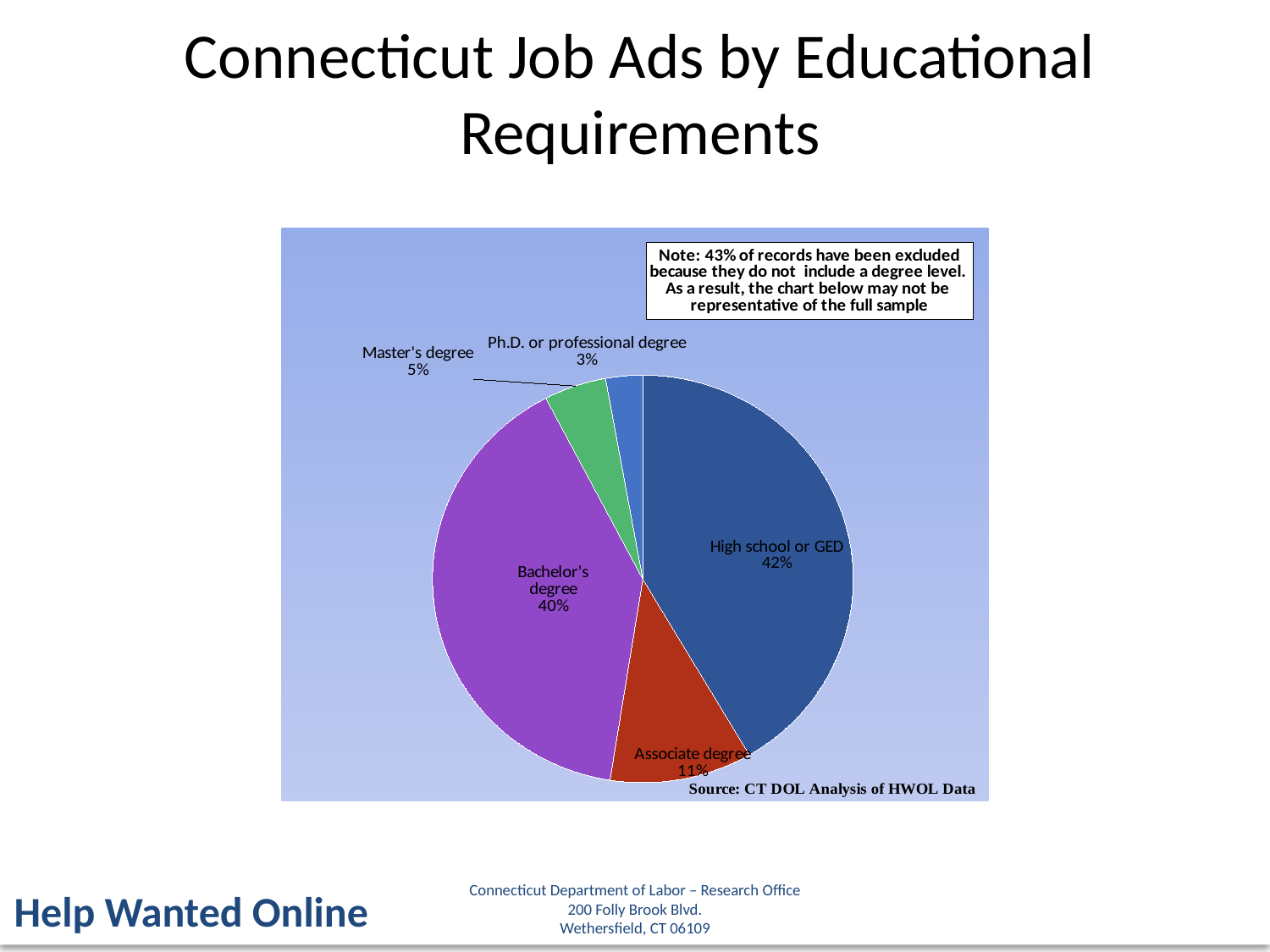
Which educational requirement has the smallest share of job ads? Ph.D. or professional degree How many educational requirement categories are shown in the pie chart? 5 What share of job ads require a Bachelor's degree? 40% According to the note on the chart, what percentage of records were excluded because they do not include a degree level? 43% Which educational requirement has the largest share of job ads? High school or GED What is the difference in percentage points between the Bachelor's degree share and the Associate degree share? 29 What share of Connecticut job ads require a high school diploma or GED? 42% What share of job ads require an Associate degree? 11% What share of job ads require a Ph.D. or professional degree? 3% Which has a larger share of job ads: Master's degree or Associate degree? Associate degree What type of chart is shown on the slide? Pie chart What share of job ads require a Master's degree? 5%